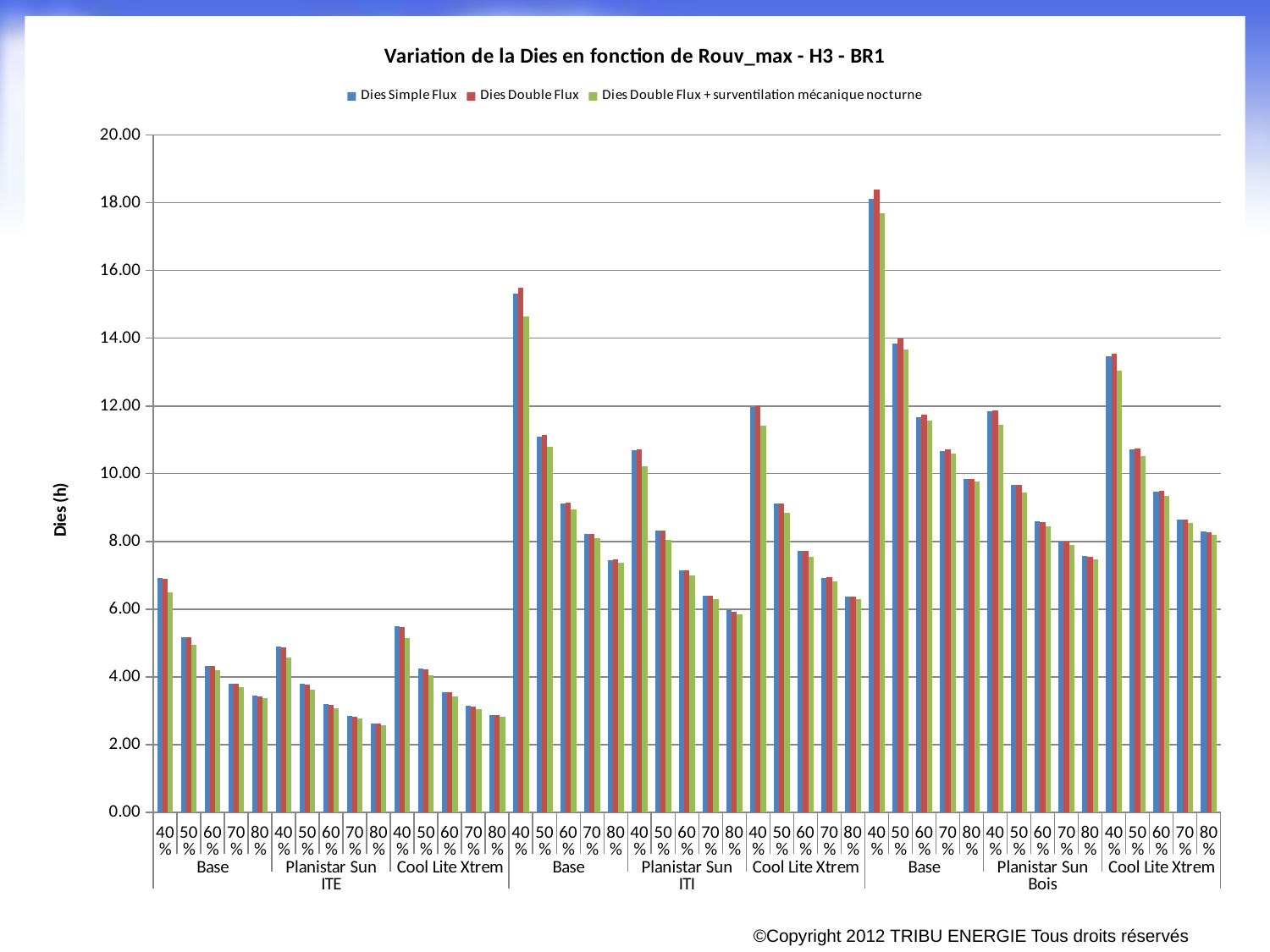
What kind of chart is shown on the slide? bar chart How many series does the legend list? 3 Which category has the lowest Dies values overall? ITE, Planistar Sun, 80% Is the Dies Double Flux value for Bois, Cool Lite Xtrem, 40% greater or less than 12.00? greater Which category has the highest Dies Double Flux value? Bois, Base, 40% How many Rouv_max percentage levels are shown for each glazing type? 5 What is the title of the chart? Variation de la Dies en fonction de Rouv_max - H3 - BR1 Within the ITE Base group, do the Dies Simple Flux values rise or fall as Rouv_max goes from 40% to 80%? fall What is the label of the vertical axis? Dies (h) Is the Dies Simple Flux value for Bois, Base, 40% greater or less than 16.00? greater Is the Dies Simple Flux value for ITE, Base, 40% greater or less than 8.00? less Which is larger for Base at 40%: the Dies Simple Flux value under ITI or under ITE? ITI